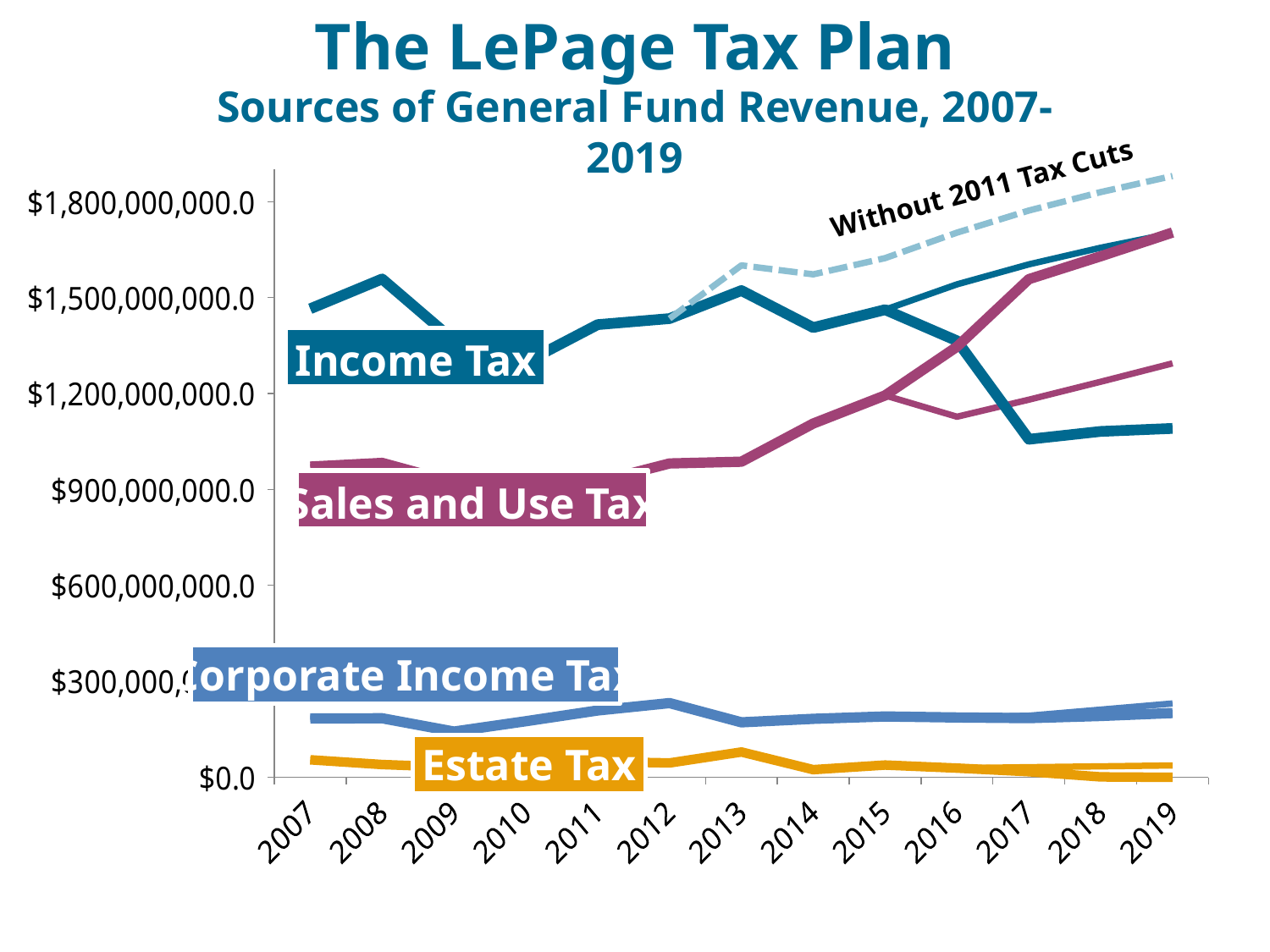
Does the Sales and Use Tax line rise or fall from 2013 to 2019? Rise What is the label on the dashed line at the top right of the chart? Without 2011 Tax Cuts Is the Sales and Use Tax value for 2007 greater or less than $900,000,000.0? greater Which revenue source has the lowest values across all years shown? Estate Tax Which revenue source has the highest value in 2007? Income Tax What is the first year shown on the x axis? 2007 Is the Income Tax value for 2008 greater or less than $1,500,000,000.0? greater How many years are shown along the x axis of the chart? 13 What kind of chart is shown on the slide? Line chart Is the Corporate Income Tax value for 2012 greater or less than $300,000,000.0? less